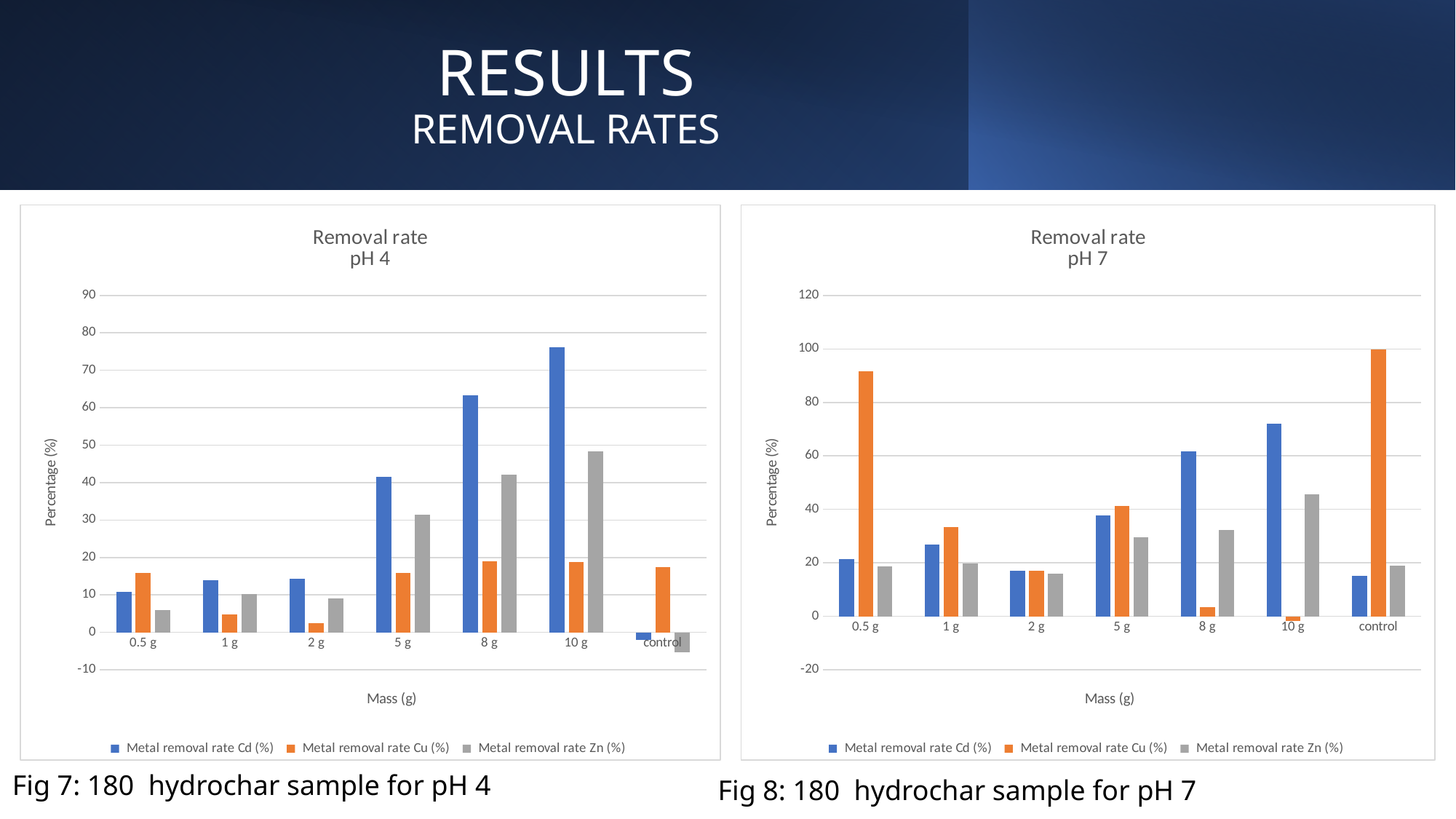
In the "Removal rate pH 4" chart, at which mass is the Metal removal rate Cd (%) highest? 10 g What type of chart is the "Removal rate pH 4" chart? bar chart In the "Removal rate pH 4" chart, at which mass is the Metal removal rate Cu (%) lowest? 2 g In the "Removal rate pH 4" chart, is the Metal removal rate Cd (%) at 10 g greater or less than 70? greater How many mass categories are shown on the x axis of the "Removal rate pH 4" chart? 7 In the "Removal rate pH 7" chart, is the Metal removal rate Cu (%) at 0.5 g greater or less than 80? greater How many series does the legend of the "Removal rate pH 7" chart list? 3 In the "Removal rate pH 7" chart, at which mass is the Metal removal rate Cu (%) lowest? 10 g What is the y-axis label of the "Removal rate pH 7" chart? Percentage (%) In the "Removal rate pH 7" chart, at which category is the Metal removal rate Cu (%) highest? control In the "Removal rate pH 4" chart, which is larger at 8 g: the Metal removal rate Cd (%) or the Metal removal rate Zn (%)? Metal removal rate Cd (%) In the "Removal rate pH 7" chart, which is larger at 10 g: the Metal removal rate Cd (%) or the Metal removal rate Zn (%)? Metal removal rate Cd (%)